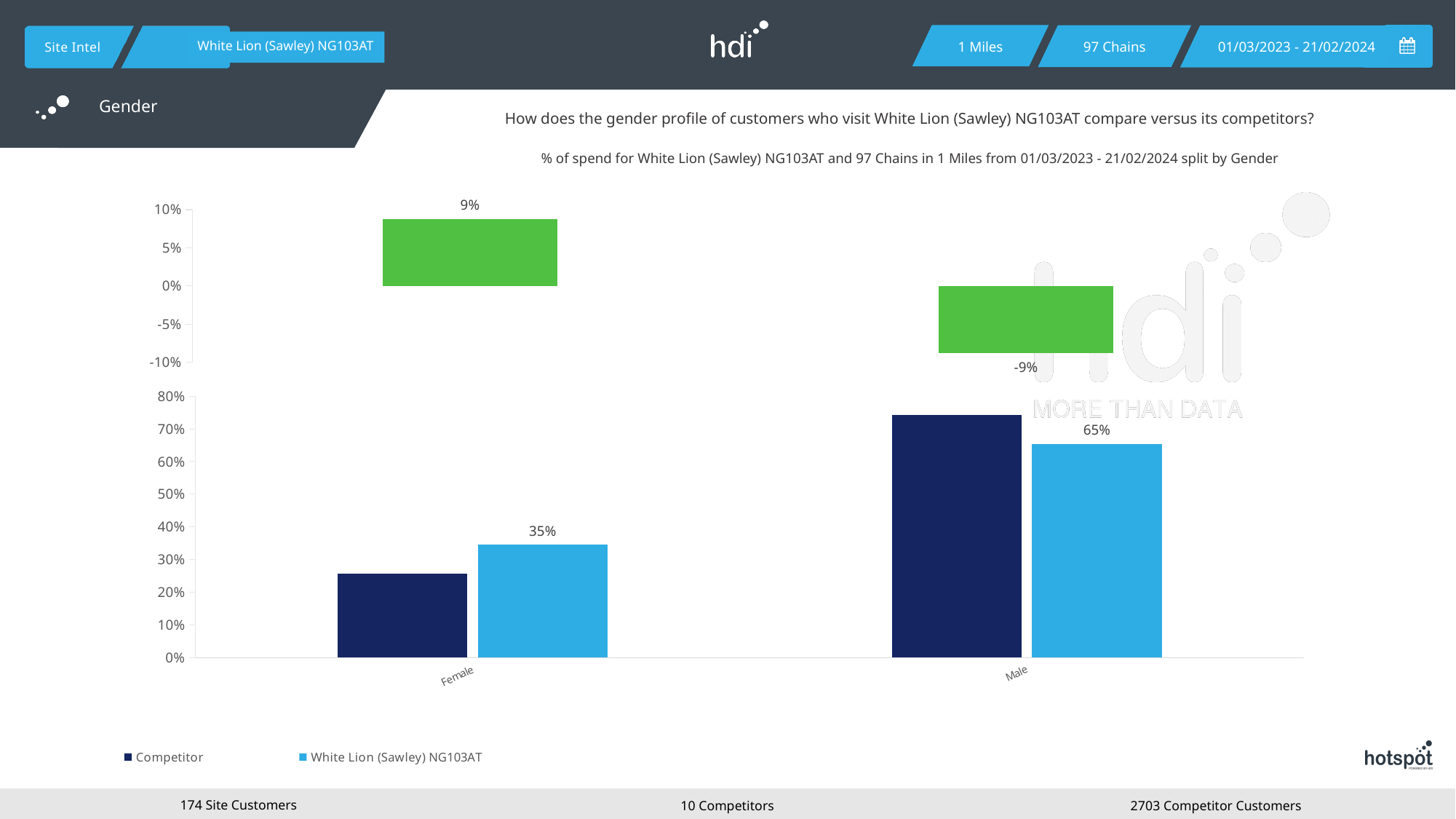
How many series does the legend of the bottom bar chart list? 2 In the bottom bar chart, what is the value for White Lion (Sawley) NG103AT for Female? 35% In the bottom bar chart, which is larger for Female: Competitor or White Lion (Sawley) NG103AT? White Lion (Sawley) NG103AT What kind of chart is the bottom chart? bar chart In the bottom bar chart, is the Competitor value for Female greater or less than 30%? less How many categories are shown on the x axis of the bottom bar chart? 2 In the top chart (green bars), what is the value shown for Female? 9% In the top chart (green bars), what is the value shown for Male? -9% In the bottom bar chart, what is the difference between the White Lion (Sawley) NG103AT values for Male and Female? 30% In the bottom bar chart, which is larger for Male: Competitor or White Lion (Sawley) NG103AT? Competitor In the bottom bar chart, what is the value for White Lion (Sawley) NG103AT for Male? 65% In the bottom bar chart, is the Competitor value for Male greater or less than 70%? greater